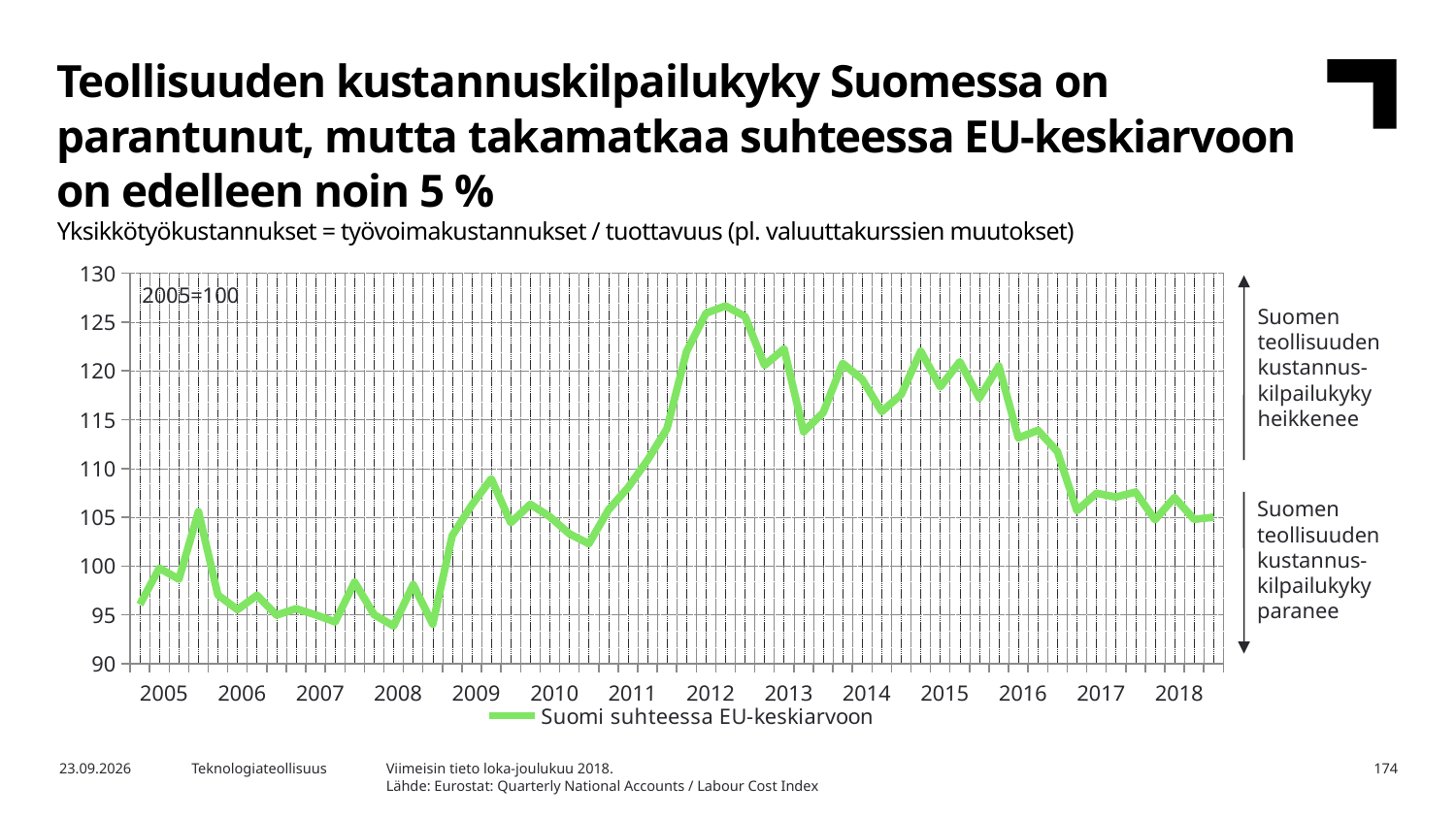
How many years are labelled on the x axis? 14 Is the peak value of the line in 2012 greater or less than 125? greater What base-year note is printed inside the chart area? 2005=100 How many series does the legend list? 1 Does the line rise or fall between 2008 and 2012? rise What is the name of the series shown in the legend? Suomi suhteessa EU-keskiarvoon Is the value at the end of 2018 greater or less than 110? less Is the lowest value of the line in 2008 greater or less than 95? less Does the line rise or fall between 2012 and 2018? fall In which year does the line reach its highest value? 2012 What kind of chart is shown on the slide? line chart